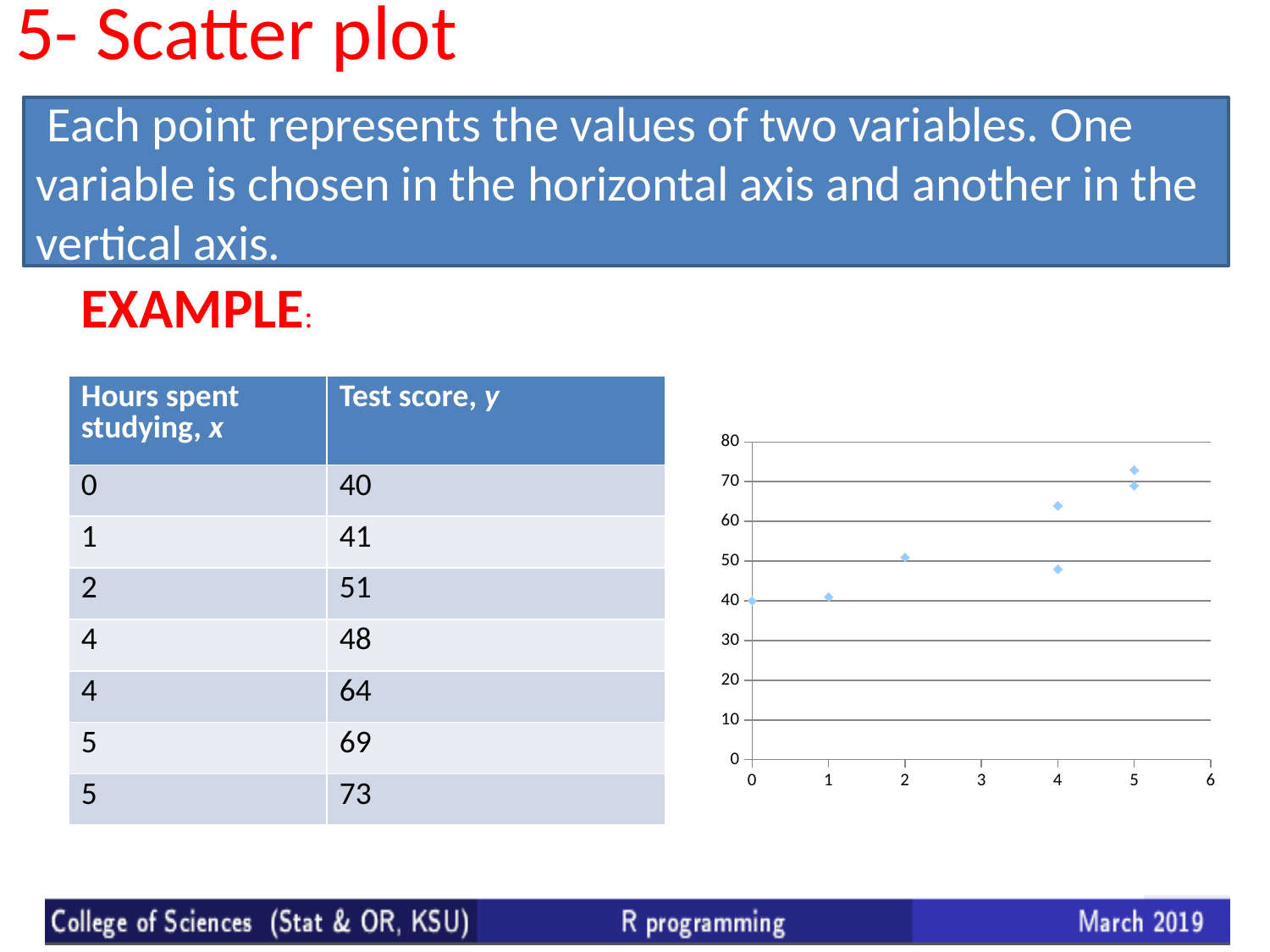
Is the higher of the two points at 4 hours greater or less than 60? greater Are both points at 5 hours greater or less than 60? greater How many points are plotted at 4 hours spent studying? 2 What is the highest test score plotted? 73 What is the difference between the highest test score (73) and the lowest test score (40)? 33 What is the test score for 0 hours spent studying? 40 What kind of chart is shown on the slide? Scatter plot Is the test score for 1 hour of studying greater or less than 50? less Do the test scores generally rise or fall as hours spent studying increase along the x axis? Rise At which number of hours spent studying is the lowest point plotted? 0 What is the largest value shown on the vertical axis of the scatter plot? 80 How many points are plotted on the scatter plot? 7